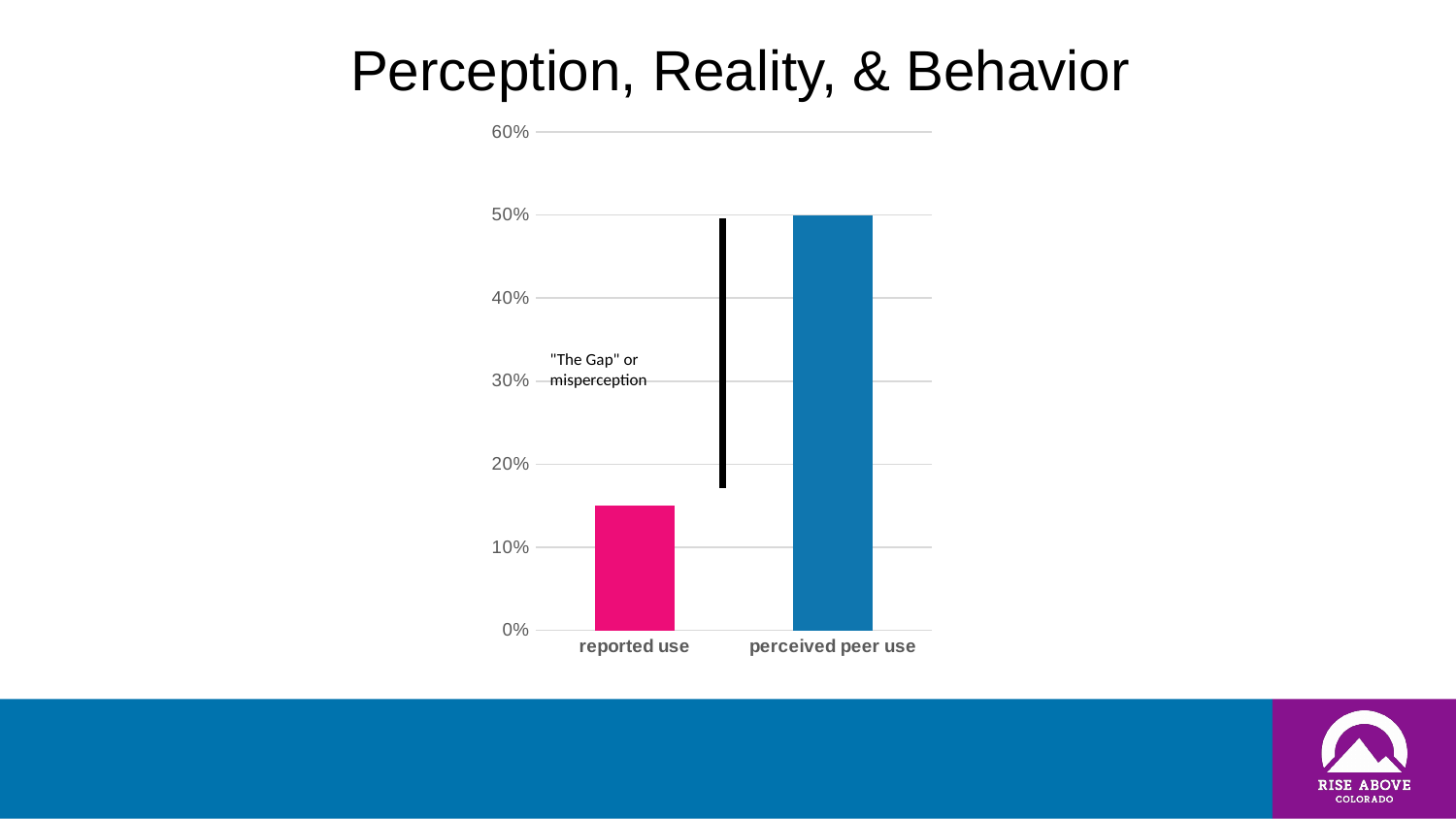
Is the value for perceived peer use greater or less than 40%? greater Is the value for reported use greater or less than 10%? greater What does the annotation next to the vertical black line between the two bars say? "The Gap" or misperception How many categories are plotted on the x axis of the chart? 2 Which category has the lowest bar in the chart? reported use What is the title of the slide containing the chart? Perception, Reality, & Behavior Which category has the highest bar in the chart? perceived peer use What value does the bar for perceived peer use reach on the y axis? 50% Is the value for reported use greater or less than 20%? less Which is larger, the value for reported use or the value for perceived peer use? perceived peer use What kind of chart is shown on the slide? bar chart